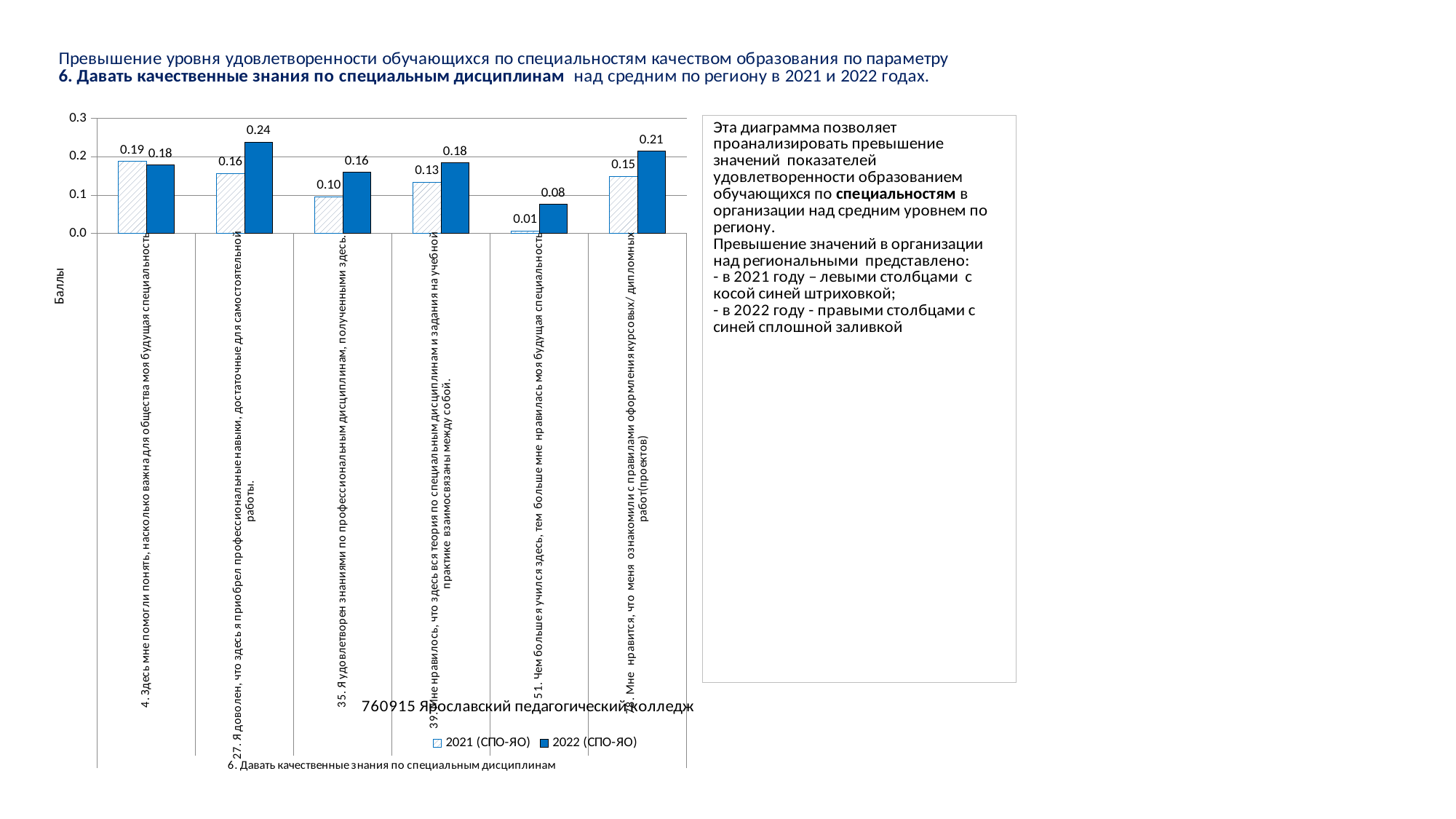
How many series does the chart legend list? 2 What kind of chart is shown on the slide? bar chart For the statement "4. Здесь мне помогли понять, насколько важна для общества моя будущая специальность", which is larger: the 2021 value or the 2022 value? 2021 What is the 2021 (СПО-ЯО) value for the statement "51. Чем больше я учился здесь, тем больше мне нравилась моя будущая специальность"? 0.01 What is the 2021 (СПО-ЯО) value for the statement "35. Я удовлетворен знаниями по профессиональным дисциплинам, полученными здесь"? 0.10 What is the 2022 (СПО-ЯО) value for the statement "27. Я доволен, что здесь я приобрел профессиональные навыки, достаточные для самостоятельной работы"? 0.24 What is the label of the vertical axis of the chart? Баллы Which statement has the highest 2022 (СПО-ЯО) value? 27. Я доволен, что здесь я приобрел профессиональные навыки, достаточные для самостоятельной работы Which statement has the lowest 2021 (СПО-ЯО) value? 51. Чем больше я учился здесь, тем больше мне нравилась моя будущая специальность Is the 2022 (СПО-ЯО) value for the statement about being introduced to the rules for formatting course/diploma works greater or less than 0.2? greater What is the difference between the 2022 and 2021 values for the statement "51. Чем больше я учился здесь, тем больше мне нравилась моя будущая специальность"? 0.07 How many categories (statements) are plotted on the chart? 6